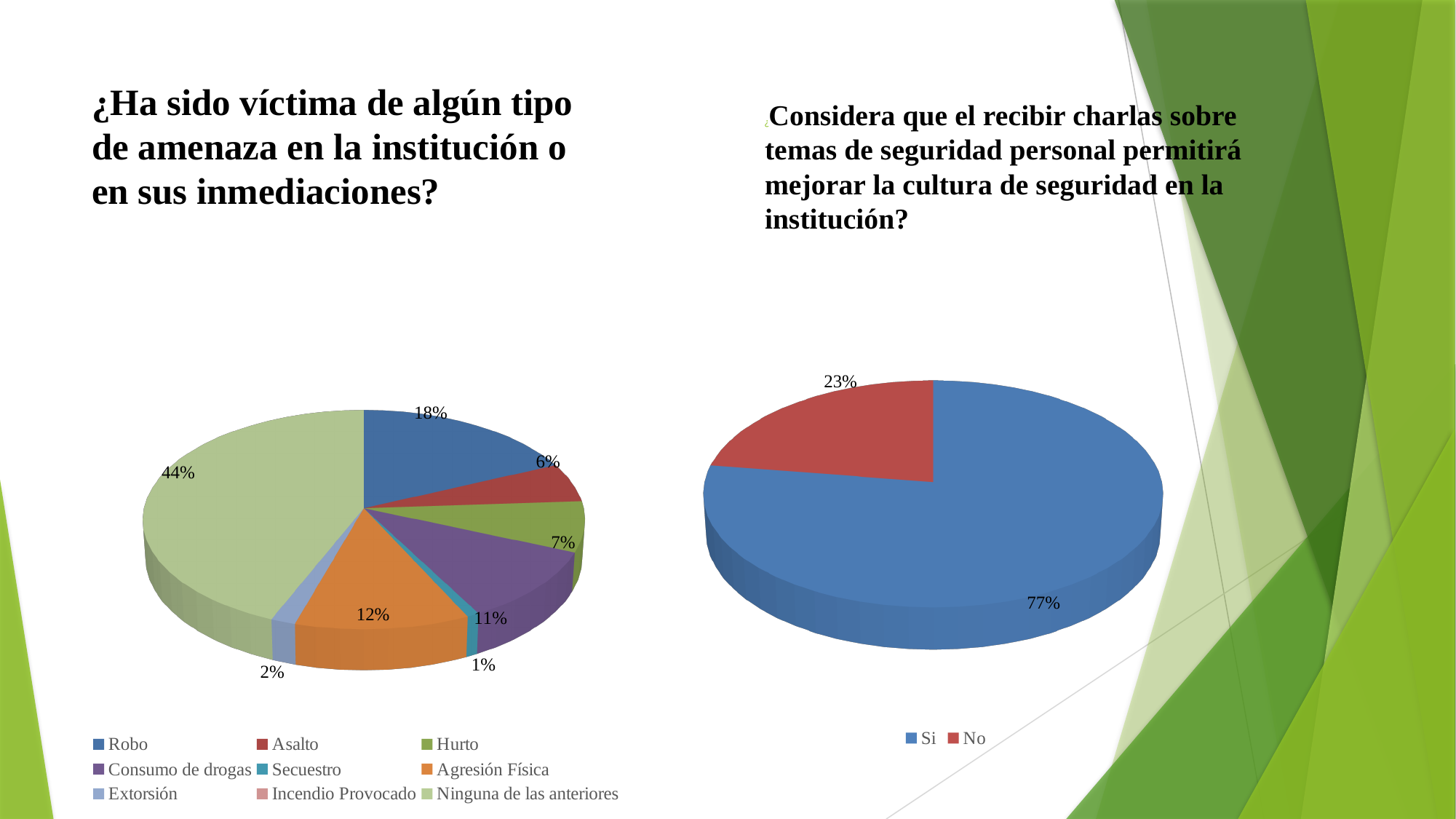
In the left pie chart, what share is labelled for Robo? 18% In the left pie chart, which is larger: Consumo de drogas or Hurto? Consumo de drogas In the right pie chart, what share is labelled for No? 23% In the left pie chart, what is the difference between the shares for Robo and Asalto? 12% In the right pie chart, what share is labelled for Si? 77% In the left pie chart, which labelled slice is the smallest? Secuestro How many entries does the legend of the left pie chart list? 9 In the right pie chart, what is the difference between the shares for Si and No? 54% In the left pie chart, what share is labelled for Ninguna de las anteriores? 44% In the left pie chart, what share is labelled for Agresión Física? 12% What type of chart is used on the left side of the slide? Pie chart In the left pie chart, which category has the largest slice? Ninguna de las anteriores